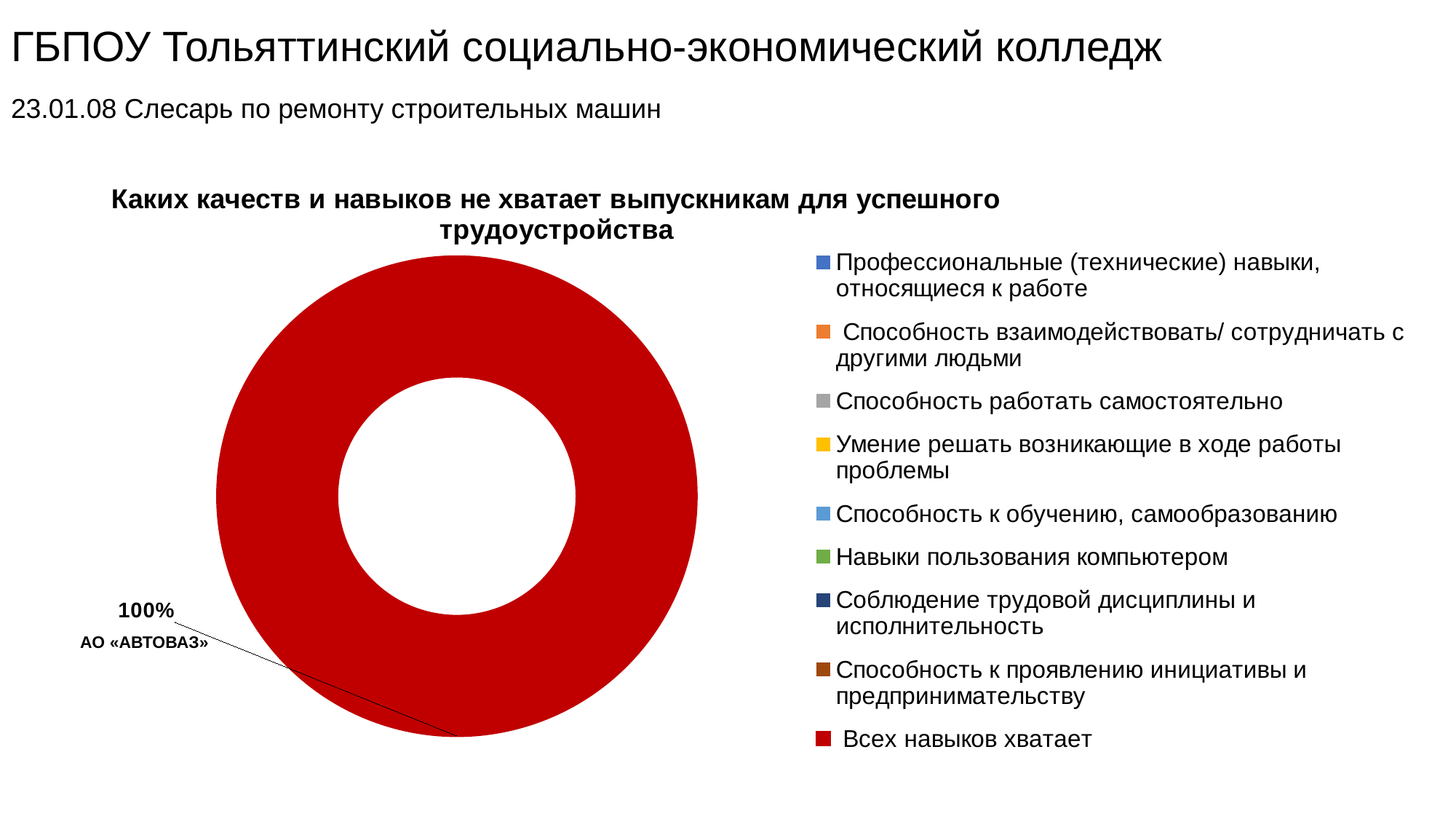
What share of the chart does the slice "Всех навыков хватает" take? 100% What is the title of the chart? Каких качеств и навыков не хватает выпускникам для успешного трудоустройства What kind of chart is shown on the slide? Doughnut (pie) chart What colour is the slice labelled "Всех навыков хватает"? Red What percentage value is printed as a data label on the chart? 100% Is the share for "Всех навыков хватает" greater or less than 50%? greater Which employer name is printed next to the 100% data label? АО «АВТОВАЗ» Which legend category accounts for the entire chart? Всех навыков хватает How many entries does the legend list? 9 How many slices are visibly plotted in the doughnut chart? 1